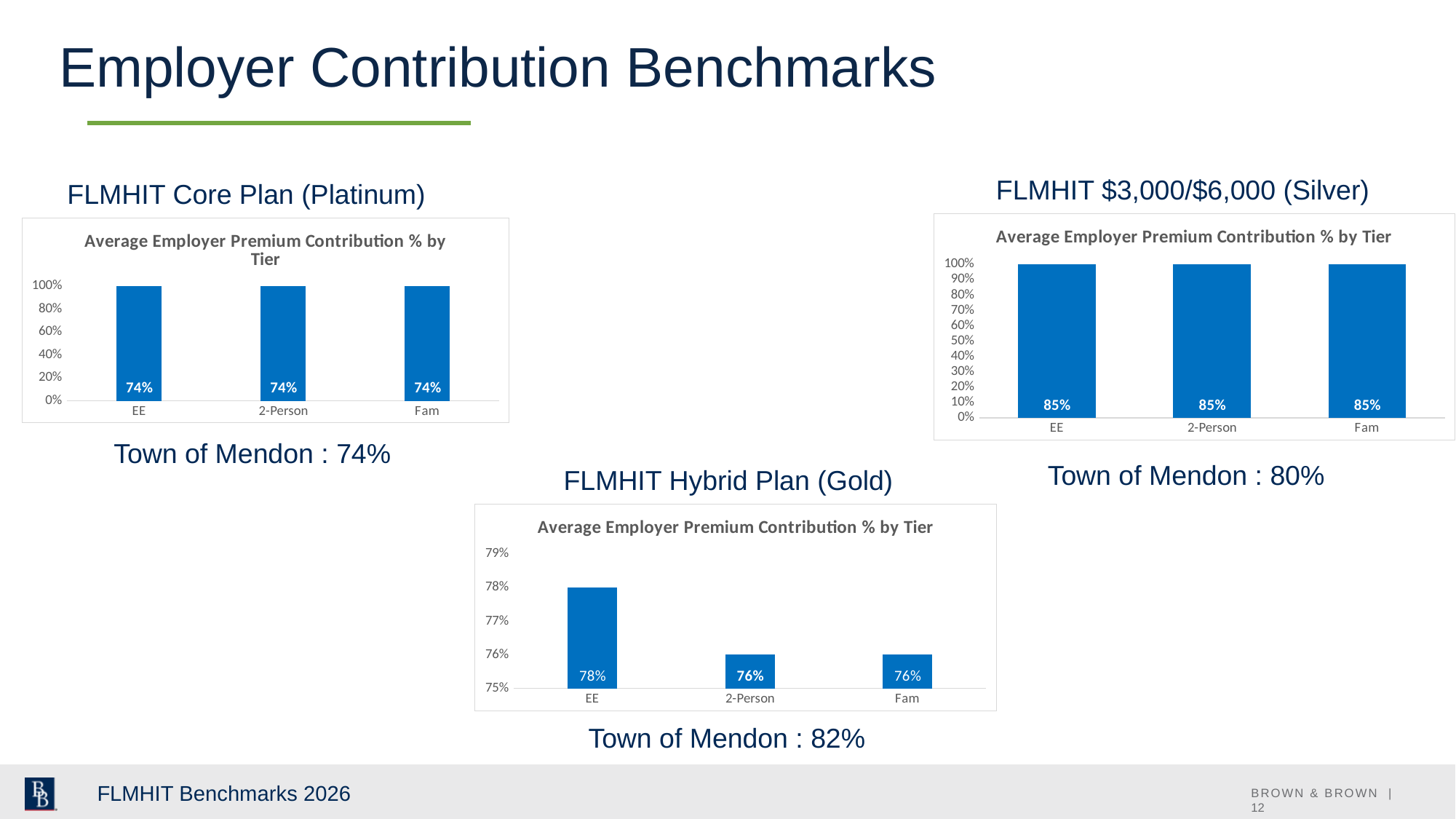
How many charts are on the slide? 3 In the FLMHIT Hybrid Plan (Gold) chart, what is the value for EE? 78% In the FLMHIT Hybrid Plan (Gold) chart, what is the difference between the EE value and the 2-Person value? 2% In the FLMHIT Hybrid Plan (Gold) chart, what is the value for Fam? 76% In the FLMHIT Core Plan (Platinum) chart, what is the value for EE? 74% In the FLMHIT Hybrid Plan (Gold) chart, do the values rise or fall from EE to 2-Person? Fall In the FLMHIT Hybrid Plan (Gold) chart, which is larger, the value for EE or the value for Fam? EE What is the title printed inside the FLMHIT Hybrid Plan (Gold) chart? Average Employer Premium Contribution % by Tier How many tiers are shown in the FLMHIT $3,000/$6,000 (Silver) chart? 3 In the FLMHIT Hybrid Plan (Gold) chart, which tier has the highest value? EE In the FLMHIT $3,000/$6,000 (Silver) chart, what is the value for 2-Person? 85% What kind of chart is the FLMHIT Core Plan (Platinum) chart? Bar chart